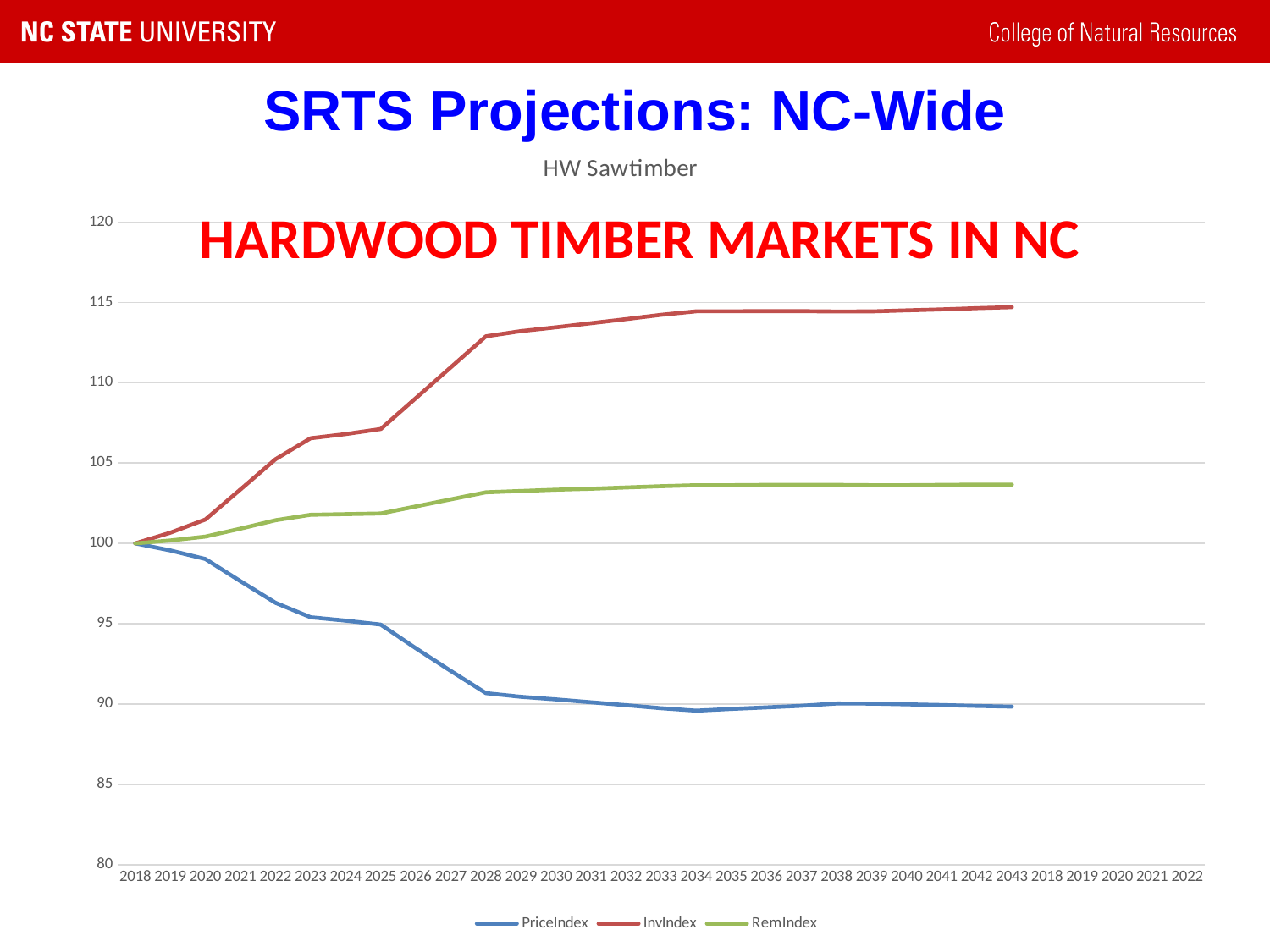
What is the title of the chart? HW Sawtimber Is the value of RemIndex in 2043 greater or less than 105? less Is the value of PriceIndex in 2043 greater or less than 95? less Does the PriceIndex series rise or fall from 2018 to 2043? fall What is the value of InvIndex in 2018? 100 Which series has the highest value in 2043? InvIndex What is the value of PriceIndex in 2018? 100 Does the InvIndex series rise or fall from 2018 to 2043? rise Is the value of InvIndex in 2043 greater or less than 110? greater How many series does the chart's legend list? 3 What kind of chart is shown on the slide? line chart Which series are listed in the chart's legend? PriceIndex, InvIndex, RemIndex